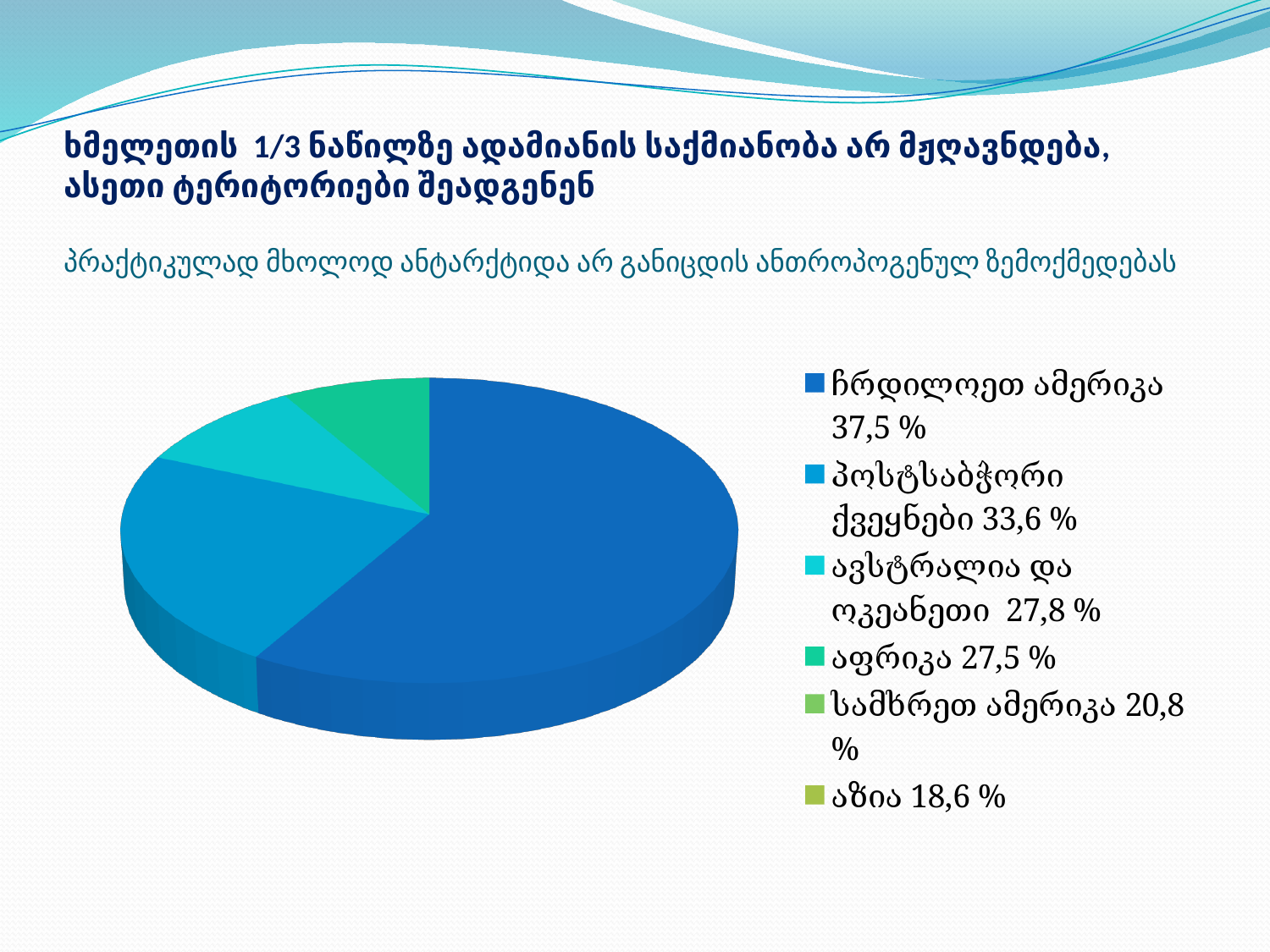
Which category has the lowest percentage in the legend? აზია What kind of chart is shown on the slide? pie chart What colour is the slice for ჩრდილოეთ ამერიკა? dark blue How many categories does the legend list? 6 What percentage is shown for პოსტსაბჭორი ქვეყნები? 33,6 % What percentage is shown for აფრიკა? 27,5 % What percentage is shown for სამხრეთ ამერიკა? 20,8 % What percentage is shown for ავსტრალია და ოკეანეთი? 27,8 % Which has a larger percentage, ჩრდილოეთ ამერიკა or აფრიკა? ჩრდილოეთ ამერიკა What percentage is shown for აზია? 18,6 % Which category has the highest percentage in the legend? ჩრდილოეთ ამერიკა What percentage is shown for ჩრდილოეთ ამერიკა in the legend? 37,5 %